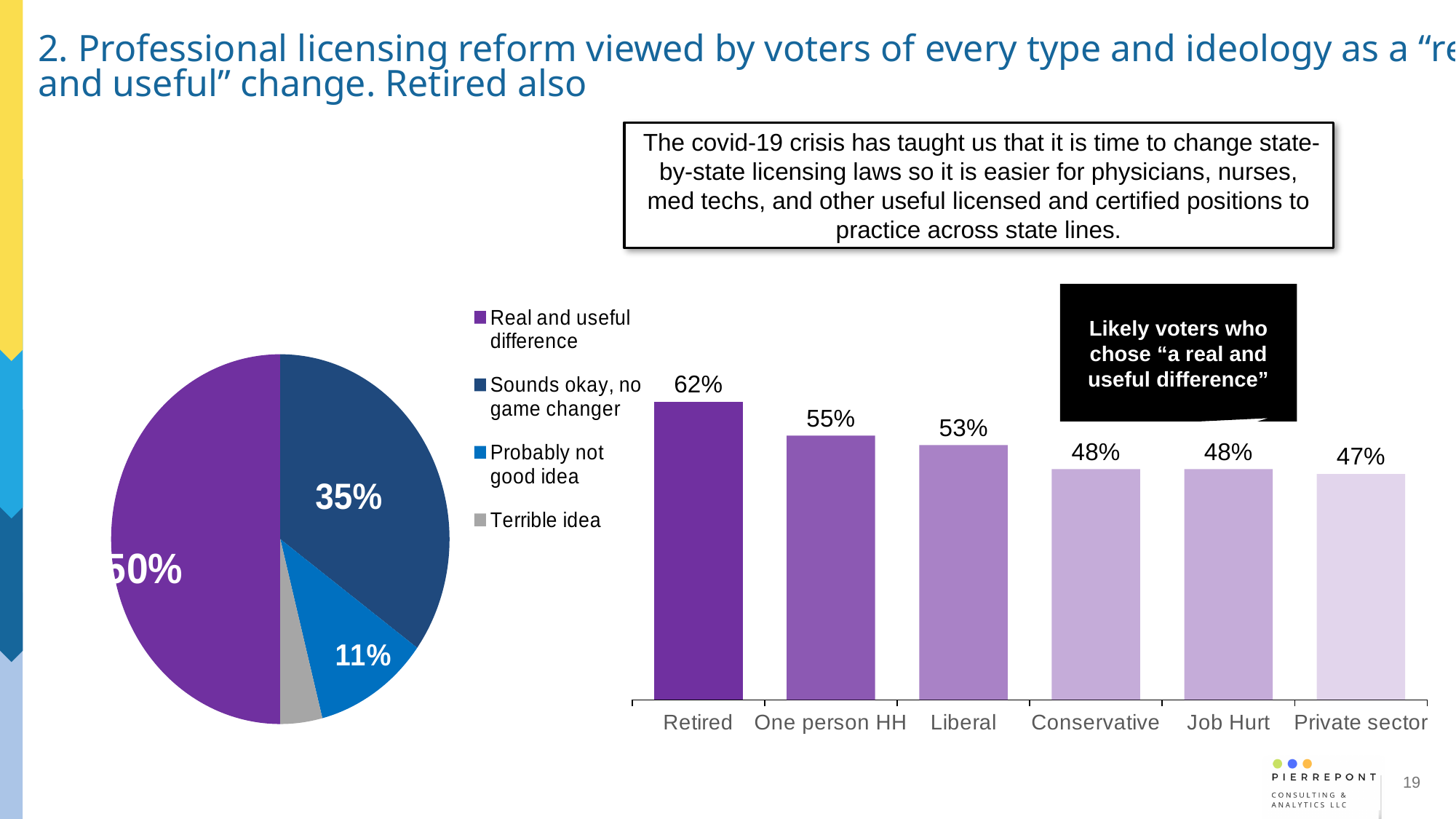
In the bar chart on the right, which is larger, the value for One person HH or the value for Conservative? One person HH In the bar chart on the right, which category has the lowest value? Private sector In the bar chart on the right, what is the difference between the values for Retired and One person HH? 7% In the bar chart on the right, what is the value for Private sector? 47% What kind of chart is the chart on the left of the slide? Pie chart In the pie chart on the left, what share of respondents chose "Sounds okay, no game changer"? 35% In the pie chart on the left, what share of respondents chose "Probably not good idea"? 11% How many entries does the legend of the pie chart on the left list? 4 In the bar chart on the right, what percentage of Retired likely voters chose "a real and useful difference"? 62% In the bar chart on the right, what is the value for Liberal? 53% In the bar chart on the right, which category has the highest value? Retired How many categories are shown in the bar chart on the right? 6